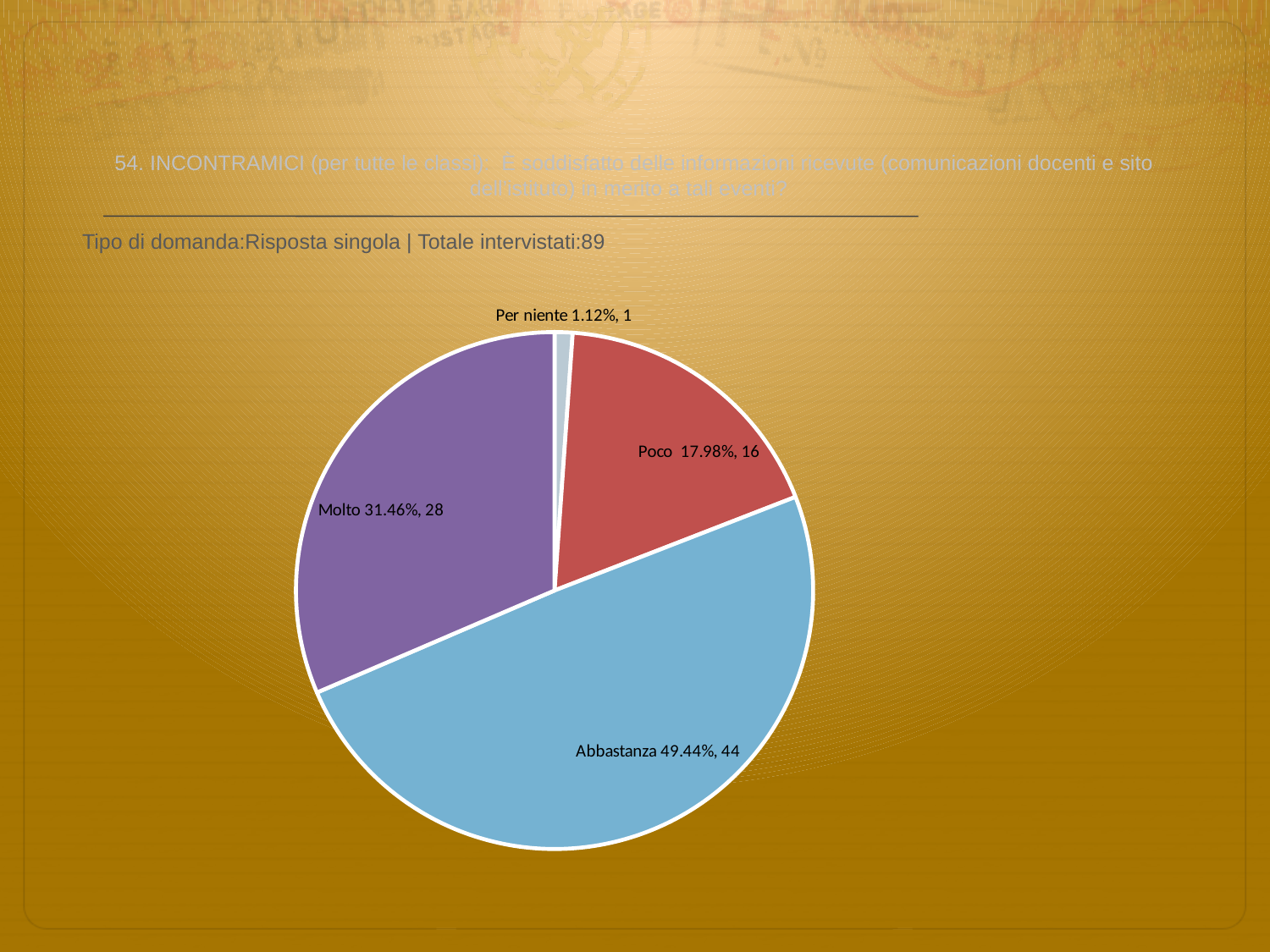
How many respondents answered Molto? 28 Which category has the largest slice? Abbastanza What colour is the Abbastanza slice? light blue What percentage share does the Per niente slice have? 1.12% Which has more respondents, Poco or Molto? Molto Which category has the smallest slice? Per niente What is the difference in respondent count between Abbastanza and Molto? 16 How many slices does the pie chart have? 4 How many respondents answered Poco? 16 What percentage share does the Abbastanza slice have? 49.44% What kind of chart is shown on the slide? pie chart What is the total number of respondents (Totale intervistati) stated on the slide? 89